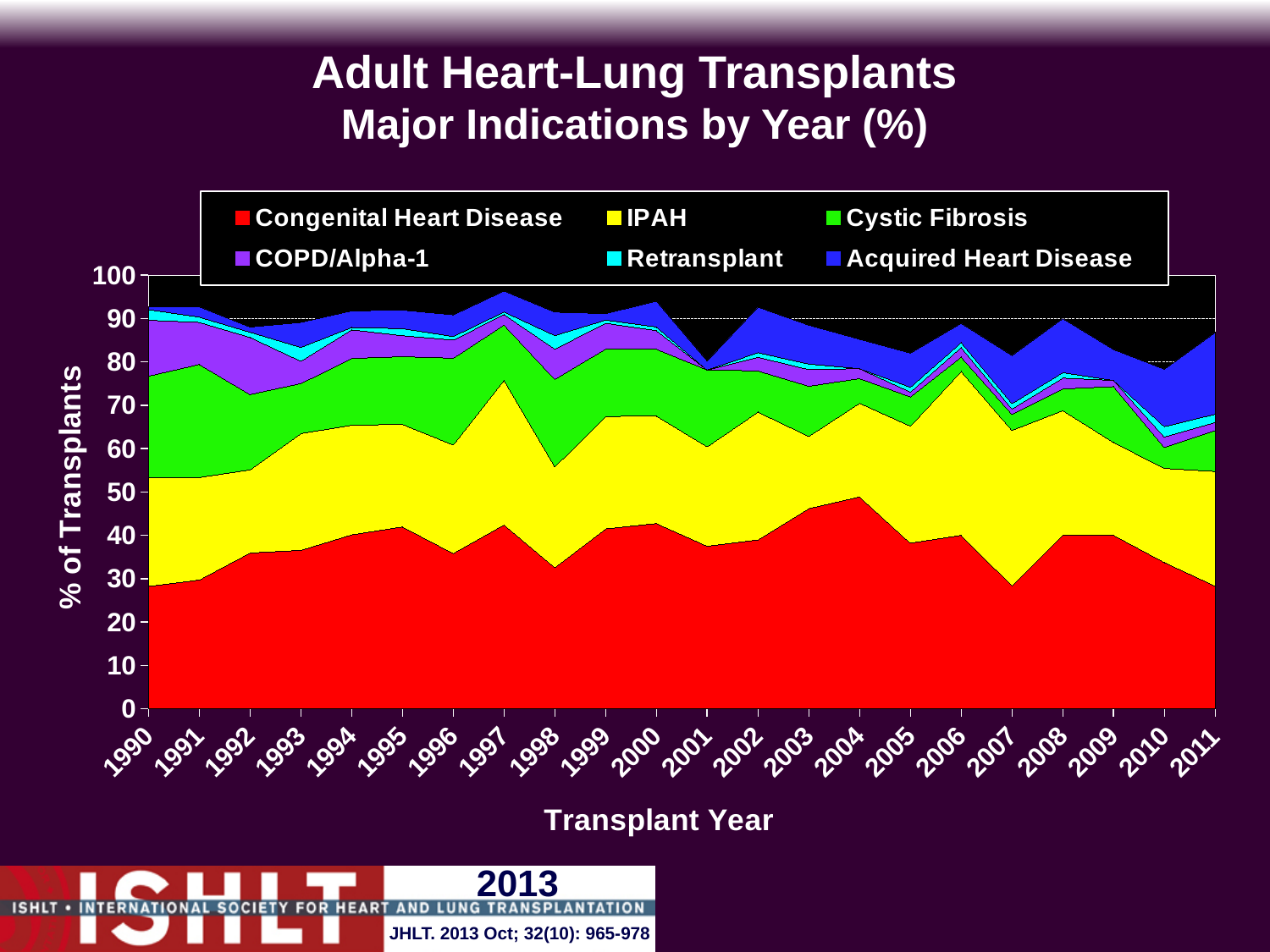
Is the cumulative top of the IPAH band in 1998 greater or less than 60? less Is the cumulative top of the IPAH band in 1997 greater or less than 70? greater What kind of chart is shown on the slide? Stacked area chart Which series is plotted at the bottom of the stack, in red? Congenital Heart Disease Which is larger, the Congenital Heart Disease share in 2004 or in 2007? 2004 Is the value for Congenital Heart Disease in 2004 greater or less than 40? greater How many transplant years are plotted along the x axis? 22 In which year does Congenital Heart Disease reach its highest share? 2004 Does the Congenital Heart Disease share rise or fall from 2009 to 2011? fall What is the label of the y axis? % of Transplants How many series does the legend list? 6